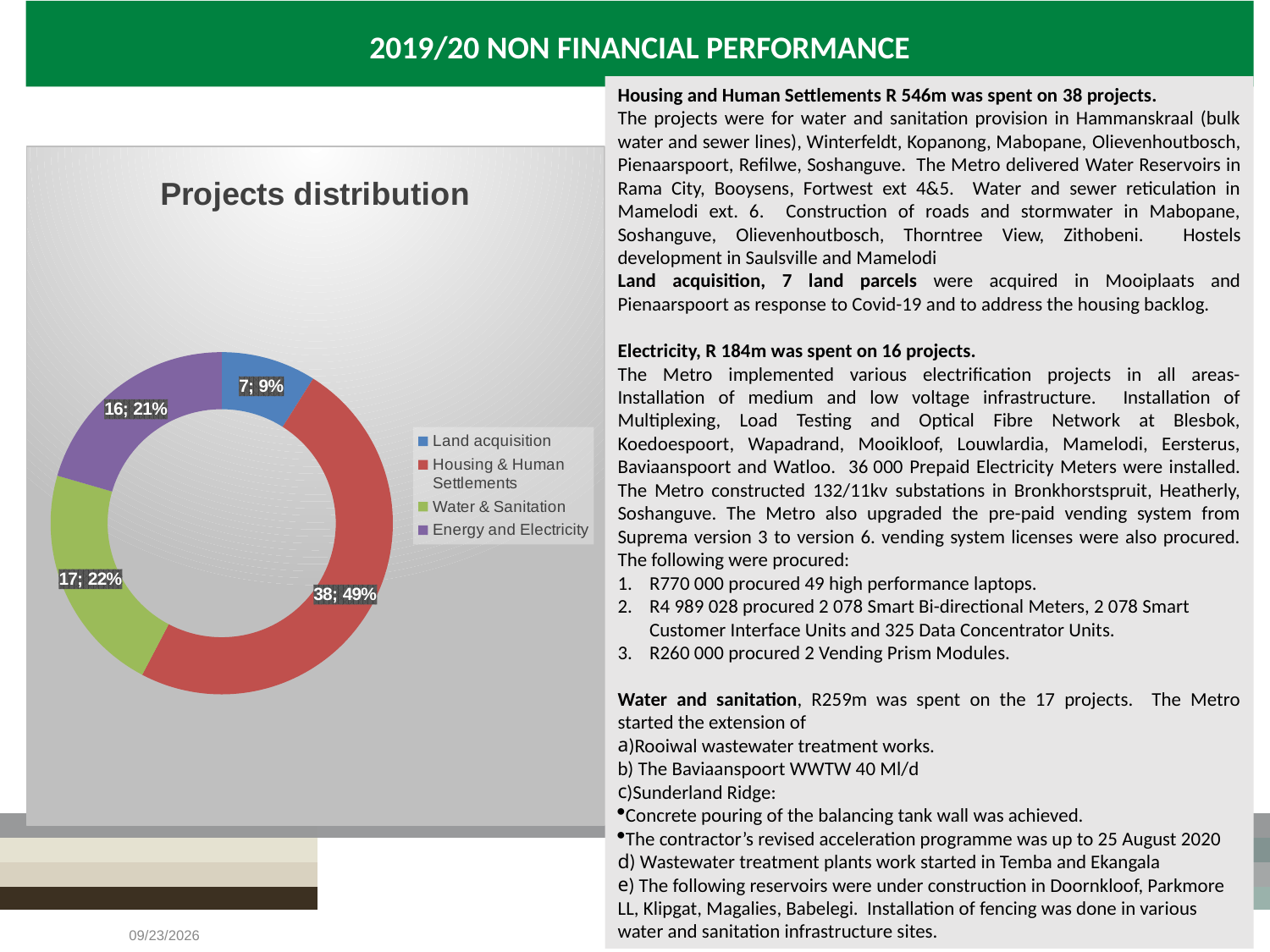
Which category has the largest share in the "Projects distribution" chart? Housing & Human Settlements In the "Projects distribution" chart, how many projects are shown for Land acquisition? 7 In the "Projects distribution" chart, which has more projects: Water & Sanitation or Energy and Electricity? Water & Sanitation In the "Projects distribution" chart, what percentage share is shown for Water & Sanitation? 22% In the "Projects distribution" chart, how many projects are shown for Housing & Human Settlements? 38 In the "Projects distribution" chart, which category is shown in red? Housing & Human Settlements What is the total number of projects across all categories in the "Projects distribution" chart? 78 How many categories does the "Projects distribution" chart show? 4 In the "Projects distribution" chart, how many more projects does Housing & Human Settlements have than Water & Sanitation? 21 Which category has the smallest share in the "Projects distribution" chart? Land acquisition What kind of chart is shown under the title "Projects distribution"? Doughnut chart In the "Projects distribution" chart, what percentage share is shown for Energy and Electricity? 21%